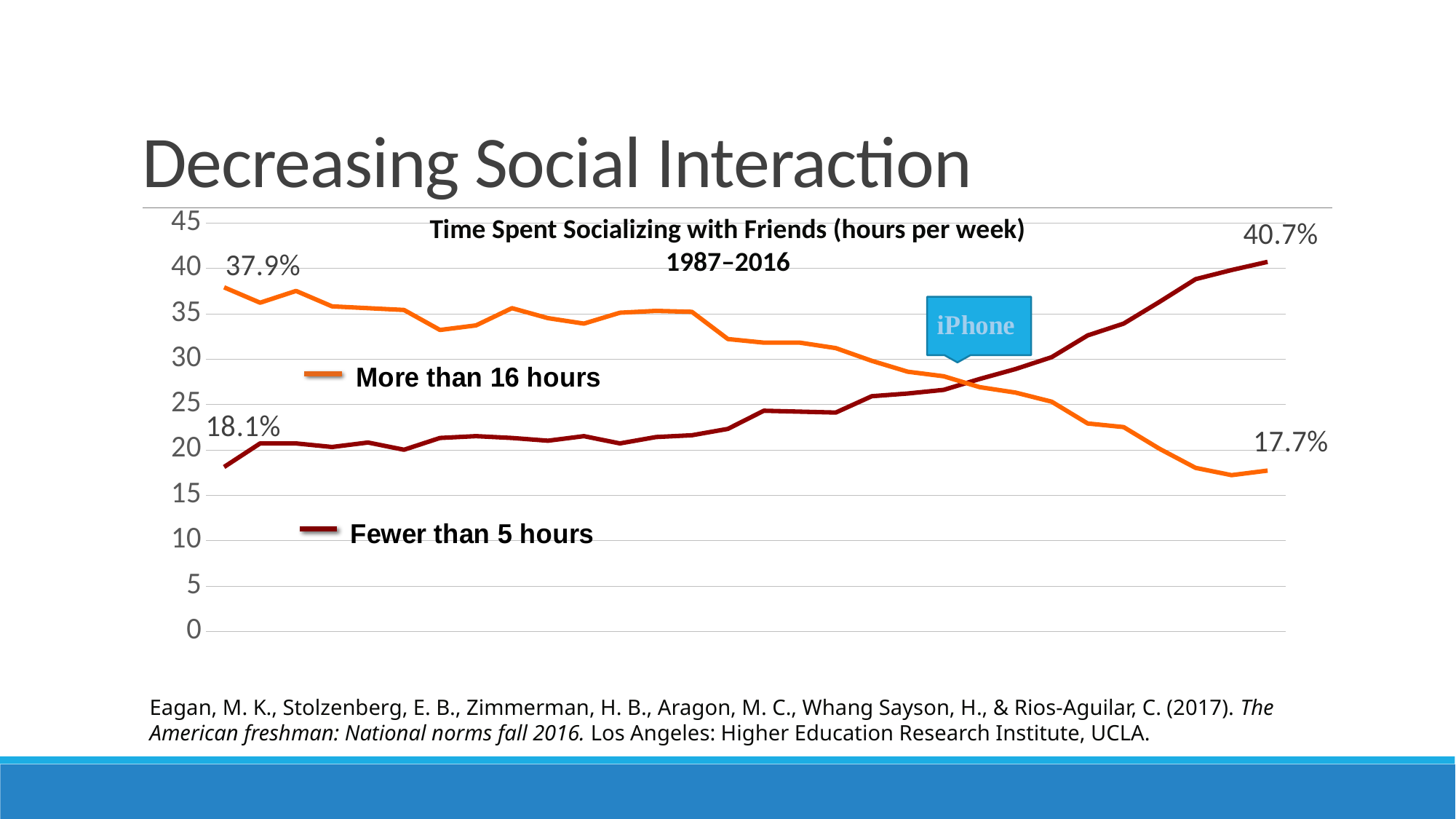
By how many percentage points does the 'Fewer than 5 hours' line rise from its first labelled value to its last? 22.6 What type of chart is shown on the slide? line chart How many series does the chart's legend list? 2 Does the 'More than 16 hours' line rise or fall over the period shown? fall What is the title of the chart? Time Spent Socializing with Friends (hours per week) 1987–2016 What is the value labelled at the start of the 'More than 16 hours' line? 37.9% Is the final value of the 'Fewer than 5 hours' line greater or less than 40? greater By how many percentage points does the 'More than 16 hours' line fall from its first labelled value to its last? 20.2 What is the value labelled at the end of the 'Fewer than 5 hours' line? 40.7% What is the value labelled at the end of the 'More than 16 hours' line? 17.7% What is the value labelled at the start of the 'Fewer than 5 hours' line? 18.1% At the start of the period, which series has the higher value: 'More than 16 hours' or 'Fewer than 5 hours'? More than 16 hours